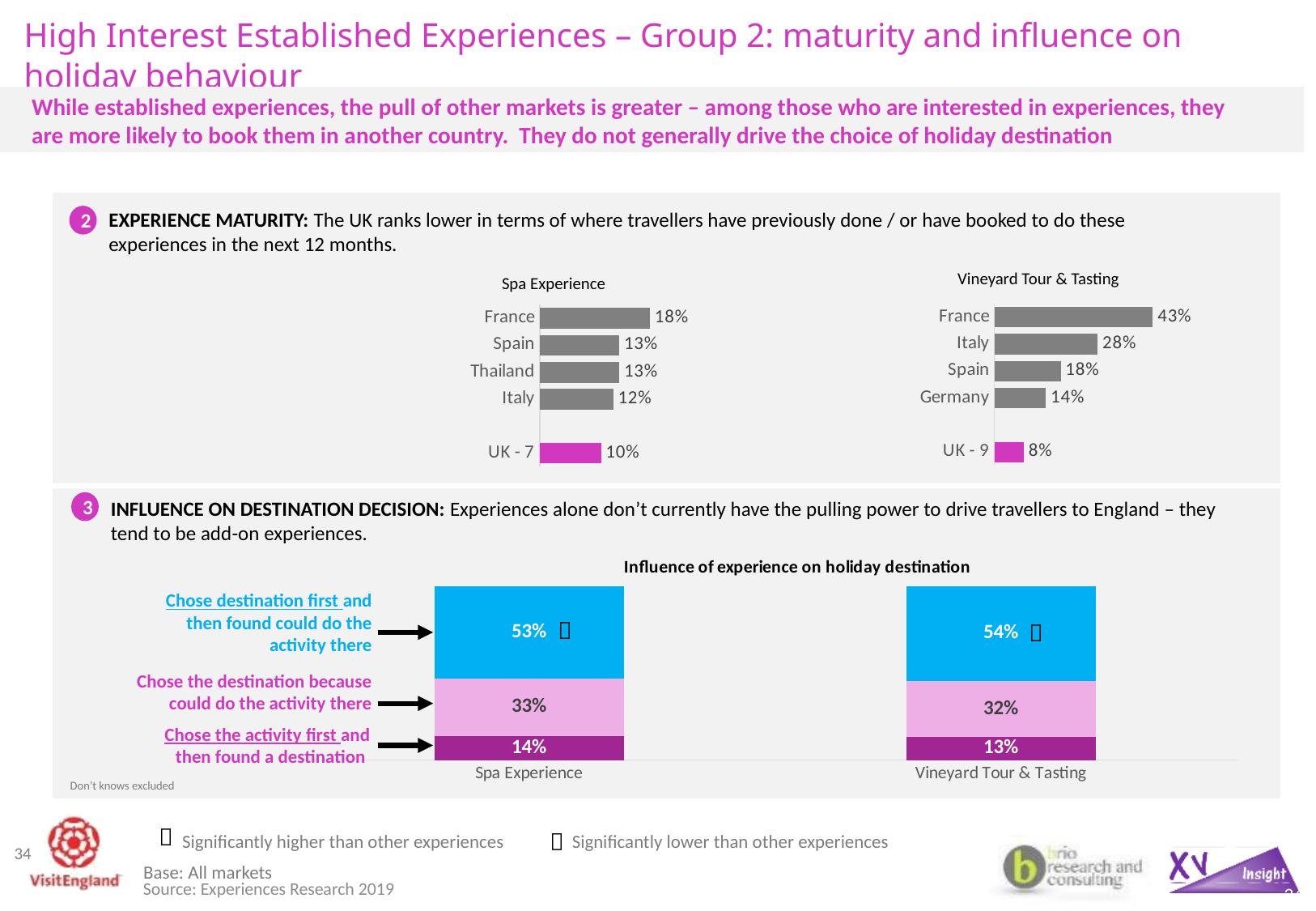
In the Influence of experience on holiday destination chart, what share of Spa Experience respondents chose the destination because they could do the activity there? 33% In the Vineyard Tour & Tasting chart, which country has the highest value? France In the Spa Experience chart, what is the value for UK - 7? 10% How many categories are shown in the Spa Experience chart? 5 In the Spa Experience chart, what is the value for France? 18% In the Influence of experience on holiday destination chart, what is the difference between the 'chose destination first' values for Vineyard Tour & Tasting and Spa Experience? 1% What kind of chart is the Influence of experience on holiday destination chart? Stacked bar chart In the Vineyard Tour & Tasting chart, what is the difference between France and Spain? 25% In the Vineyard Tour & Tasting chart, which category has the lowest value? UK - 9 In the Vineyard Tour & Tasting chart, what is the value for Italy? 28% In the Influence of experience on holiday destination chart, what is the total of the Vineyard Tour & Tasting stacked bar? 99% In the Spa Experience chart, which is larger, the value for Italy or the value for UK - 7? Italy